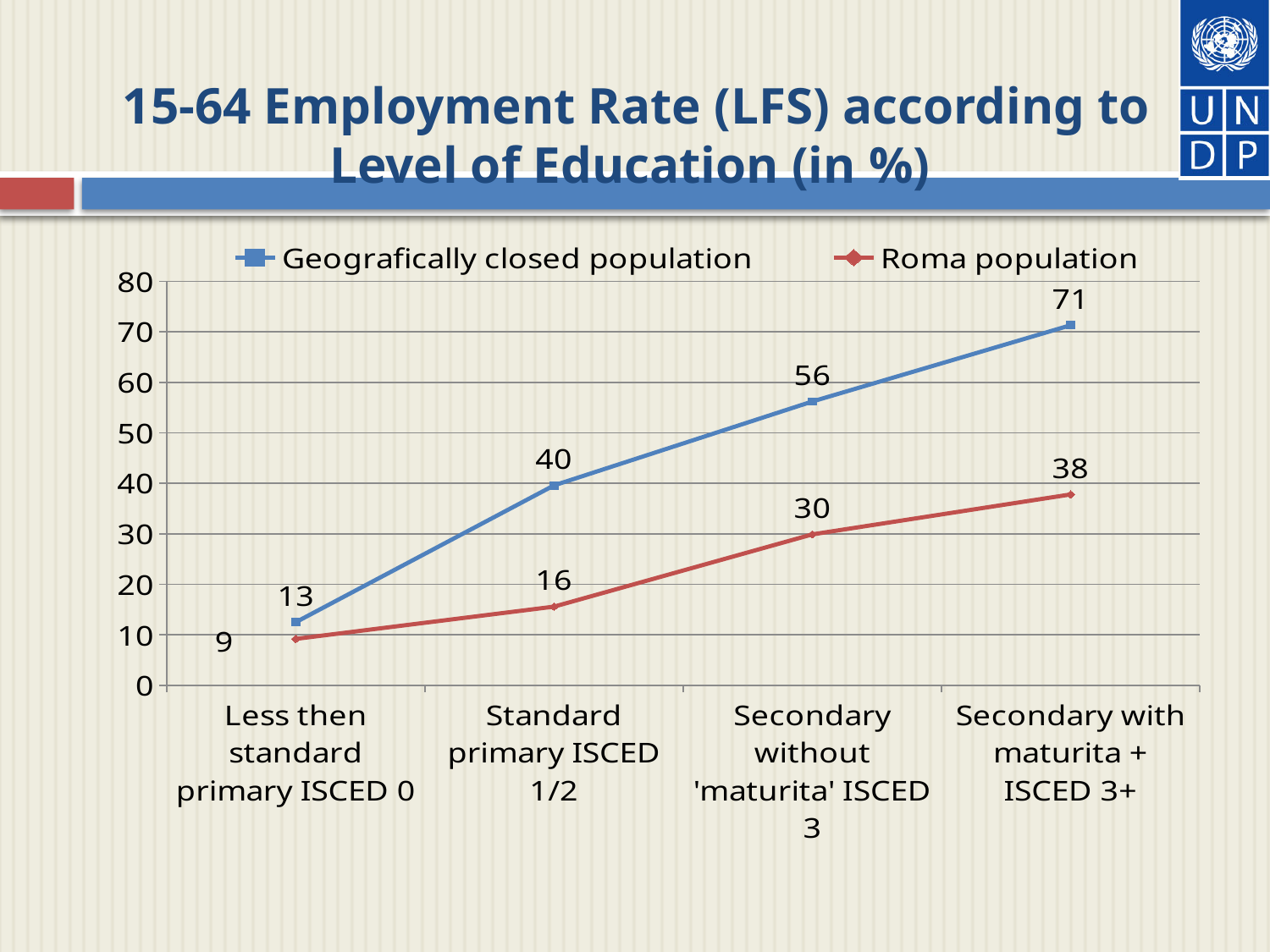
What is the employment rate for the Roma population at Standard primary ISCED 1/2? 16 How many education levels are shown on the x axis? 4 What is the employment rate for the Geografically closed population at Secondary with maturita + ISCED 3+? 71 What is the employment rate for the Roma population at Less then standard primary ISCED 0? 9 Which education level has the lowest employment rate for the Roma population? Less then standard primary ISCED 0 How many series does the legend list? 2 Which is larger at Standard primary ISCED 1/2: the Geografically closed population or the Roma population? Geografically closed population What colour is the line for the Roma population? Red Do the values for the Roma population rise or fall as the level of education increases along the x axis? Rise What kind of chart is shown on the slide? Line chart Which education level has the highest employment rate for the Geografically closed population? Secondary with maturita + ISCED 3+ What is the difference between the Geografically closed population and the Roma population at Secondary without 'maturita' ISCED 3? 26